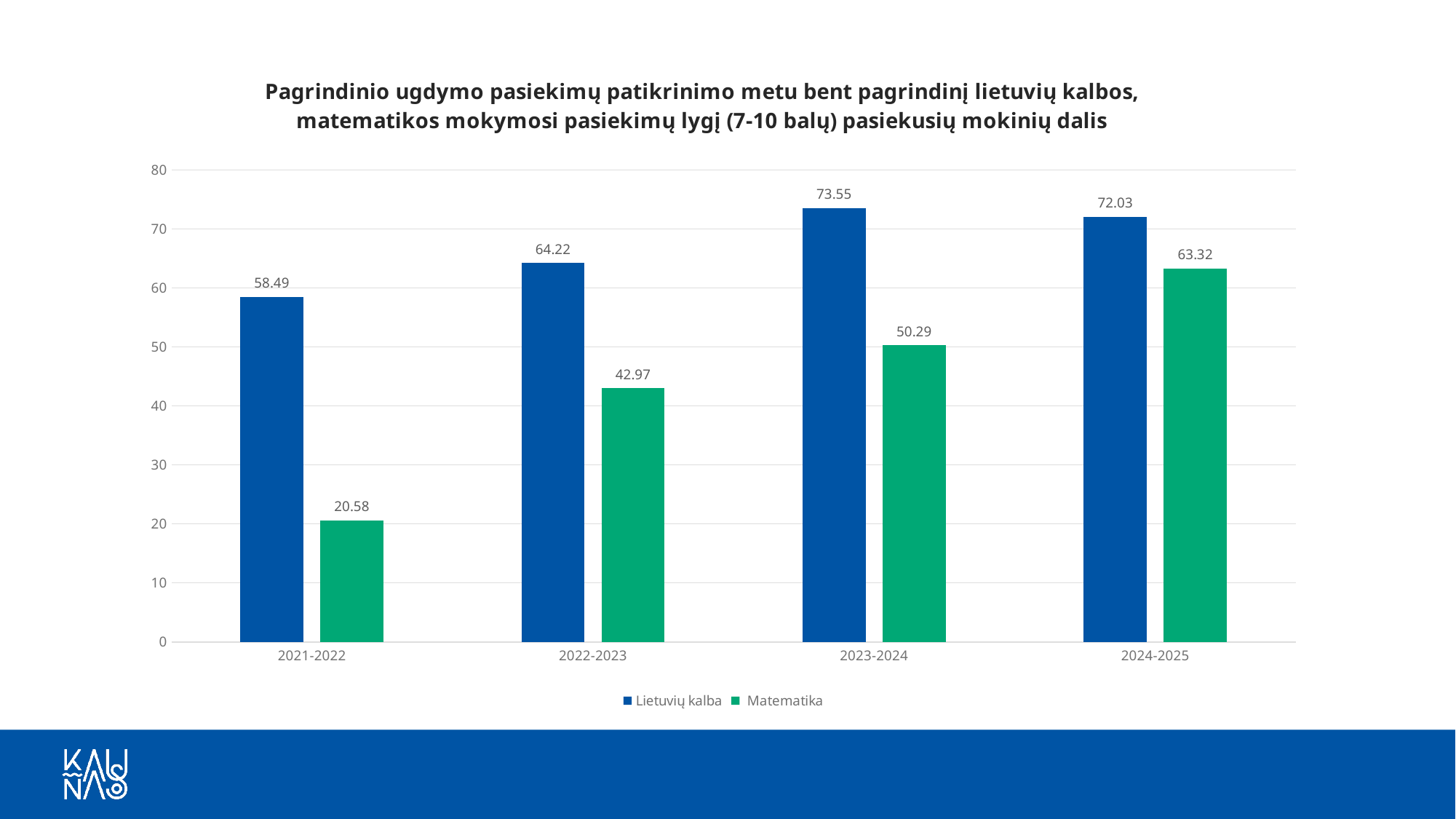
What is the difference between the Matematika values in 2024-2025 and 2023-2024? 13.03 What is the value for Matematika in 2022-2023? 42.97 How many series does the legend list? 2 Which is larger in 2024-2025: Lietuvių kalba or Matematika? Lietuvių kalba How many year categories are shown on the x axis? 4 Does the Matematika value rise or fall from 2021-2022 to 2024-2025? Rise In which year is the Matematika value lowest? 2021-2022 What is the value for Matematika in 2024-2025? 63.32 What kind of chart is shown on the slide? Bar chart What is the value for Lietuvių kalba in 2021-2022? 58.49 What is the difference between the Lietuvių kalba and Matematika values in 2021-2022? 37.91 In which year is the Lietuvių kalba value highest? 2023-2024